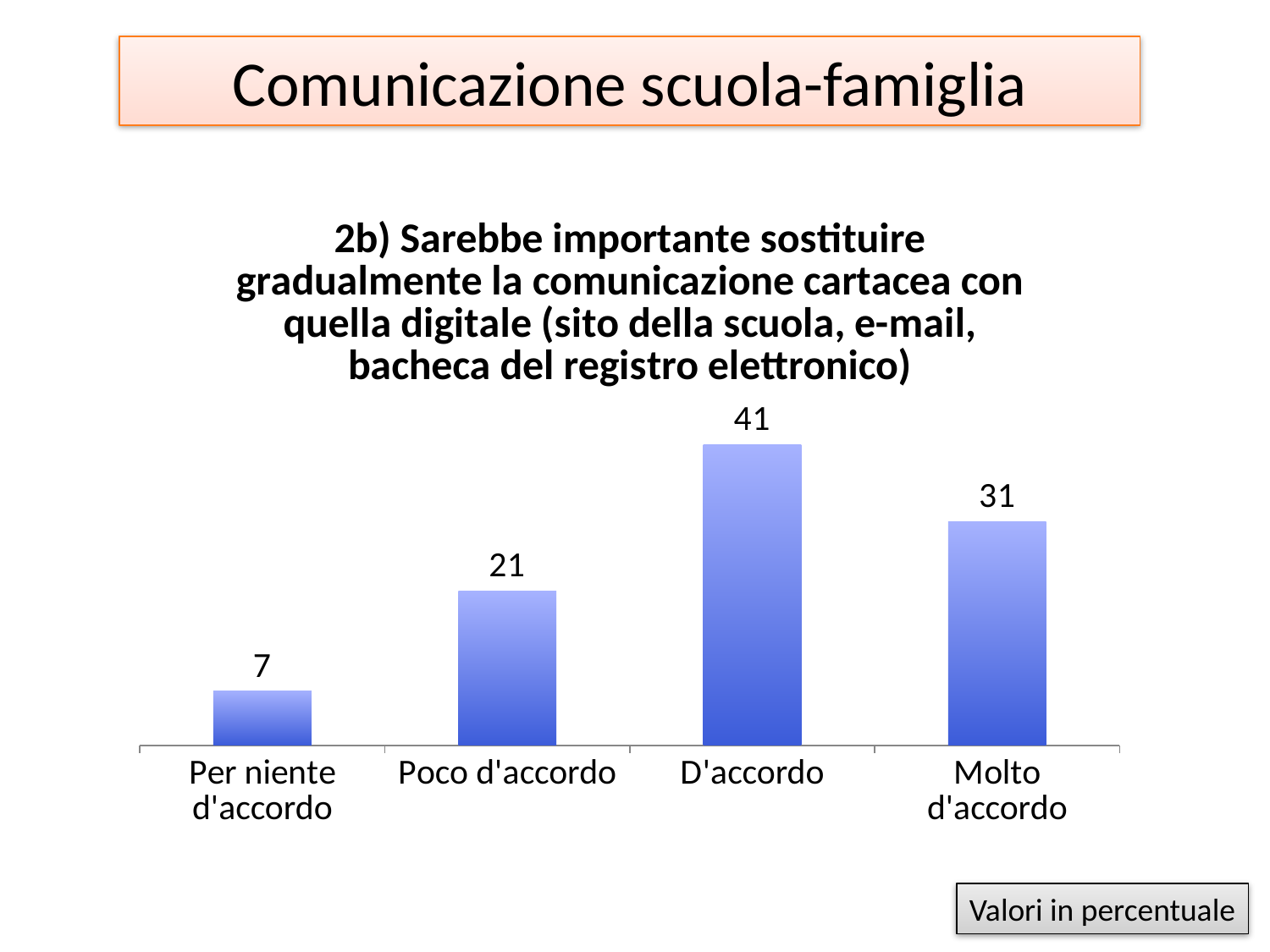
What is the value for "Per niente d'accordo"? 7 What is the value for "Poco d'accordo"? 21 Which is larger, the value for "Molto d'accordo" or the value for "Poco d'accordo"? Molto d'accordo What is the value for "Molto d'accordo"? 31 How many categories are shown on the x axis? 4 Which category has the highest value? D'accordo What is the difference between the values for "D'accordo" and "Molto d'accordo"? 10 What is the value for "D'accordo"? 41 What is the difference between the values for "Poco d'accordo" and "Per niente d'accordo"? 14 What kind of chart is shown on the slide? Bar chart Which category has the lowest value? Per niente d'accordo According to the note on the slide, in what unit are the values expressed? Percentuale (percentage)